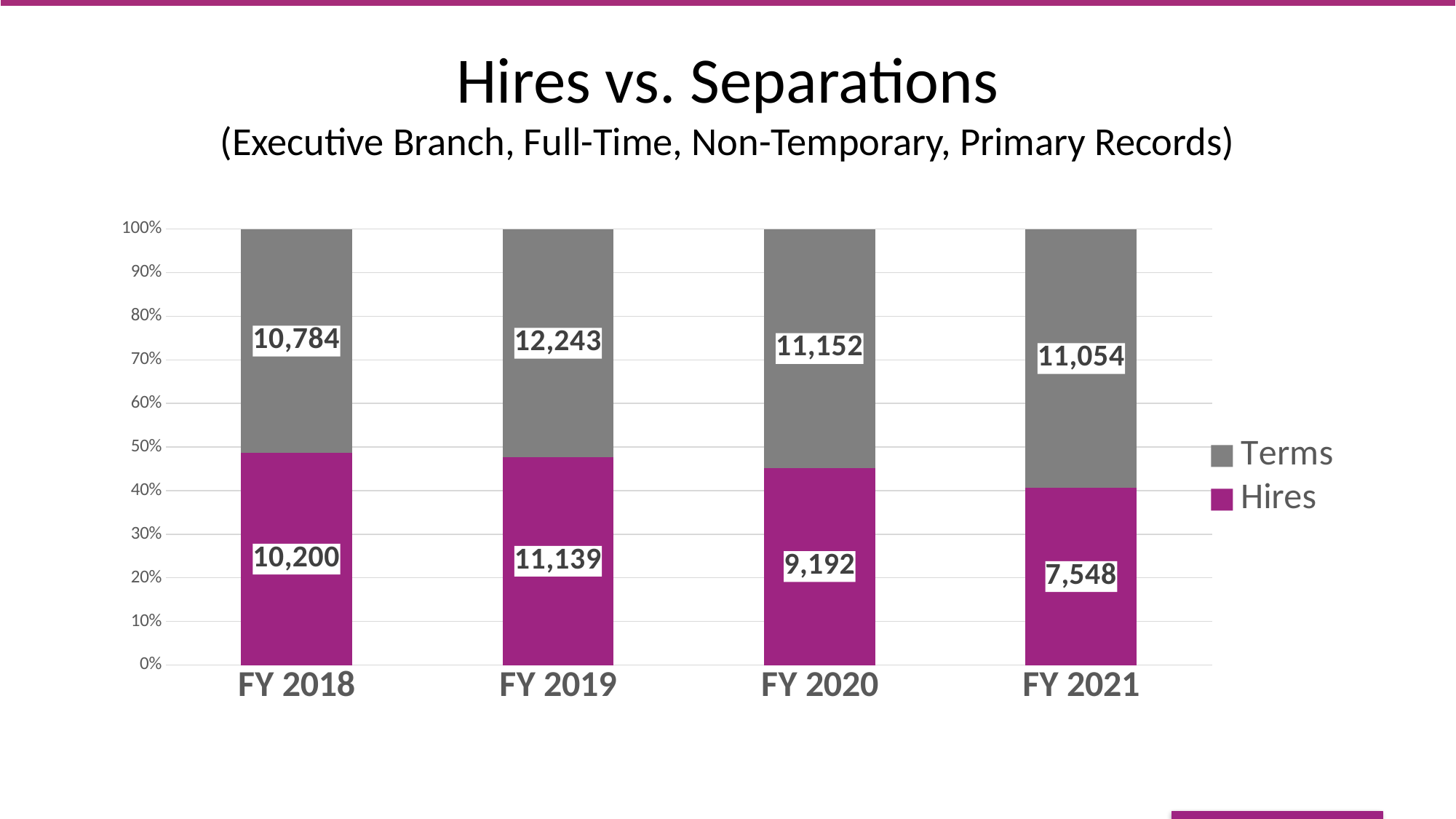
How many fiscal years are shown on the x axis? 4 What is the Terms value for FY 2019? 12,243 What is the Hires value for FY 2021? 7,548 Is the Hires share of the FY 2021 bar greater or less than 50%? less What is the Hires value for FY 2020? 9,192 What is the difference between Terms and Hires in FY 2021? 3,506 What is the combined total of Hires and Terms for FY 2018? 20,984 Which fiscal year has the lowest Terms value? FY 2018 Which fiscal year has the lowest Hires value? FY 2021 Which fiscal year has the highest Hires value? FY 2019 Which is larger in FY 2020, Hires or Terms? Terms How many series does the legend list? 2